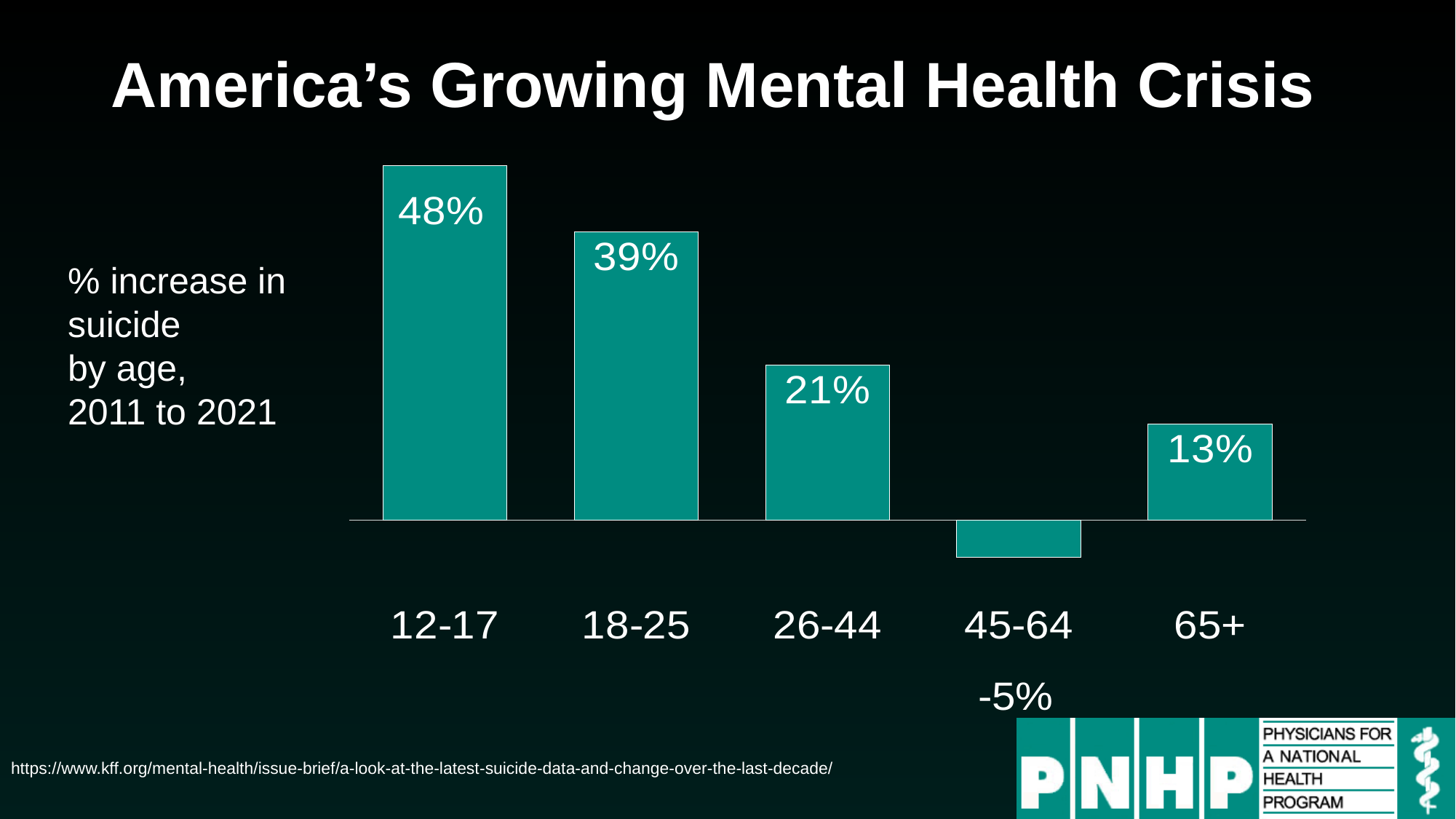
What is the value shown for the 65+ age group? 13% How many age groups are shown on the chart? 5 What is the difference between the values for the 26-44 and 65+ age groups? 8% Which age group has the lowest value on the chart? 45-64 Which age group has the highest % increase in suicide? 12-17 What is the title of the slide containing the chart? America's Growing Mental Health Crisis What kind of chart is shown on the slide? Bar chart What is the % increase in suicide for the 12-17 age group? 48% Which is larger, the value for 26-44 or the value for 65+? 26-44 What is the % increase in suicide for the 18-25 age group? 39% What is the value shown for the 45-64 age group? -5% What is the difference between the values for the 12-17 and 18-25 age groups? 9%